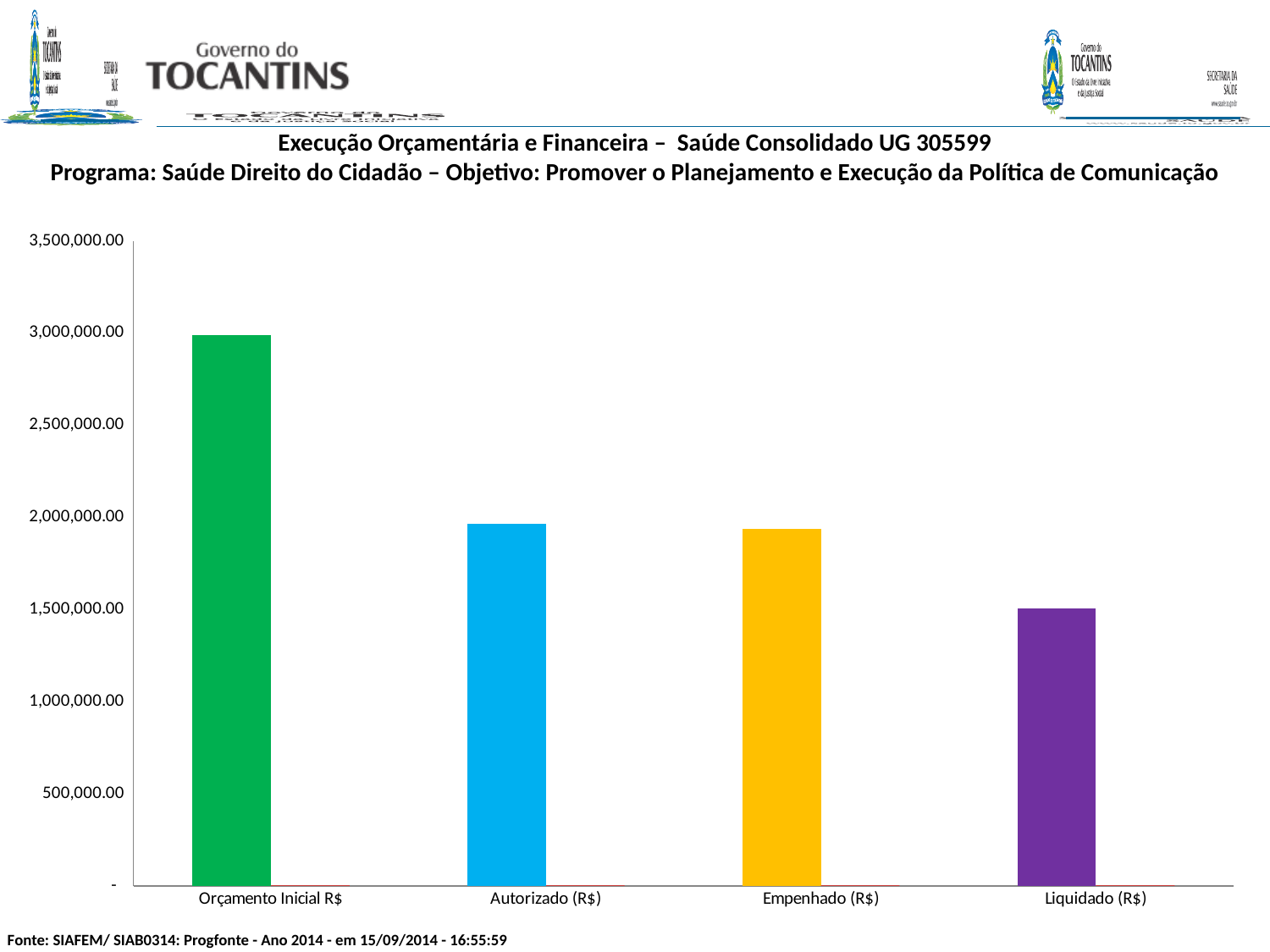
Do the values rise or fall from left to right across the categories? fall Which is larger, the value for Autorizado (R$) or the value for Liquidado (R$)? Autorizado (R$) Is the value for Empenhado (R$) greater or less than 1,500,000.00? greater Which category has the lowest value? Liquidado (R$) What kind of chart is shown on the slide? bar chart How many categories are plotted on the chart? 4 Is the value for Orçamento Inicial R$ greater or less than 2,500,000.00? greater Which category has the highest value? Orçamento Inicial R$ Which is larger, the value for Orçamento Inicial R$ or the value for Liquidado (R$)? Orçamento Inicial R$ What colour is the bar for Orçamento Inicial R$? green Is the value for Liquidado (R$) greater or less than 1,000,000.00? greater